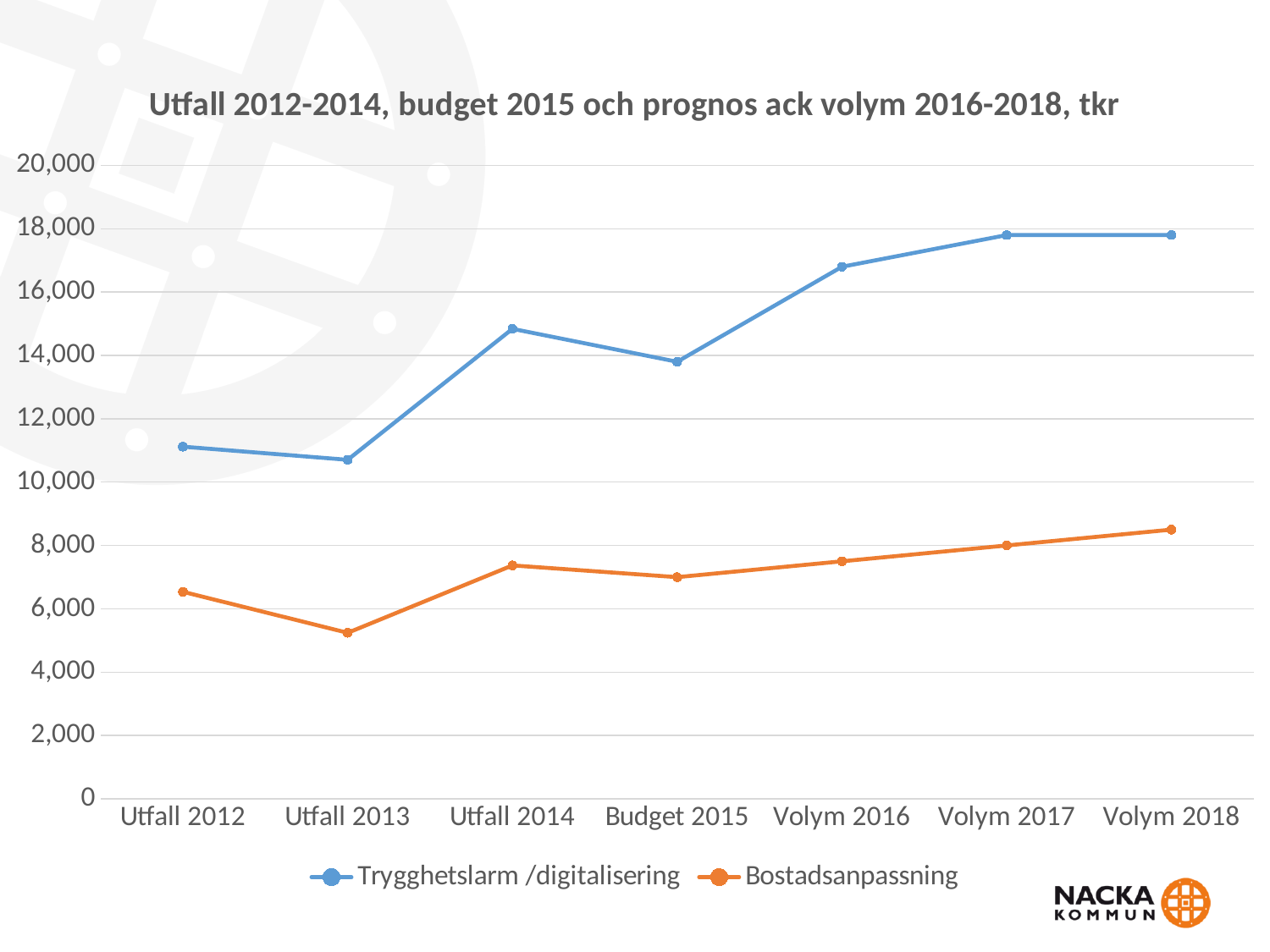
Which category has the highest value for Bostadsanpassning? Volym 2018 For Trygghetslarm /digitalisering, which is larger: the value at Utfall 2014 or at Budget 2015? Utfall 2014 How many series does the legend list? 2 Which category has the lowest value for Bostadsanpassning? Utfall 2013 Which category has the lowest value for Trygghetslarm /digitalisering? Utfall 2013 What is the title of the chart? Utfall 2012-2014, budget 2015 och prognos ack volym 2016-2018, tkr What kind of chart is shown on the slide? Line chart Do the values for Bostadsanpassning rise or fall from Budget 2015 to Volym 2018? Rise How many categories are shown along the x axis? 7 Is the value for Trygghetslarm /digitalisering at Utfall 2014 greater or less than 14,000? greater Is the value for Bostadsanpassning at Utfall 2013 greater or less than 6,000? less